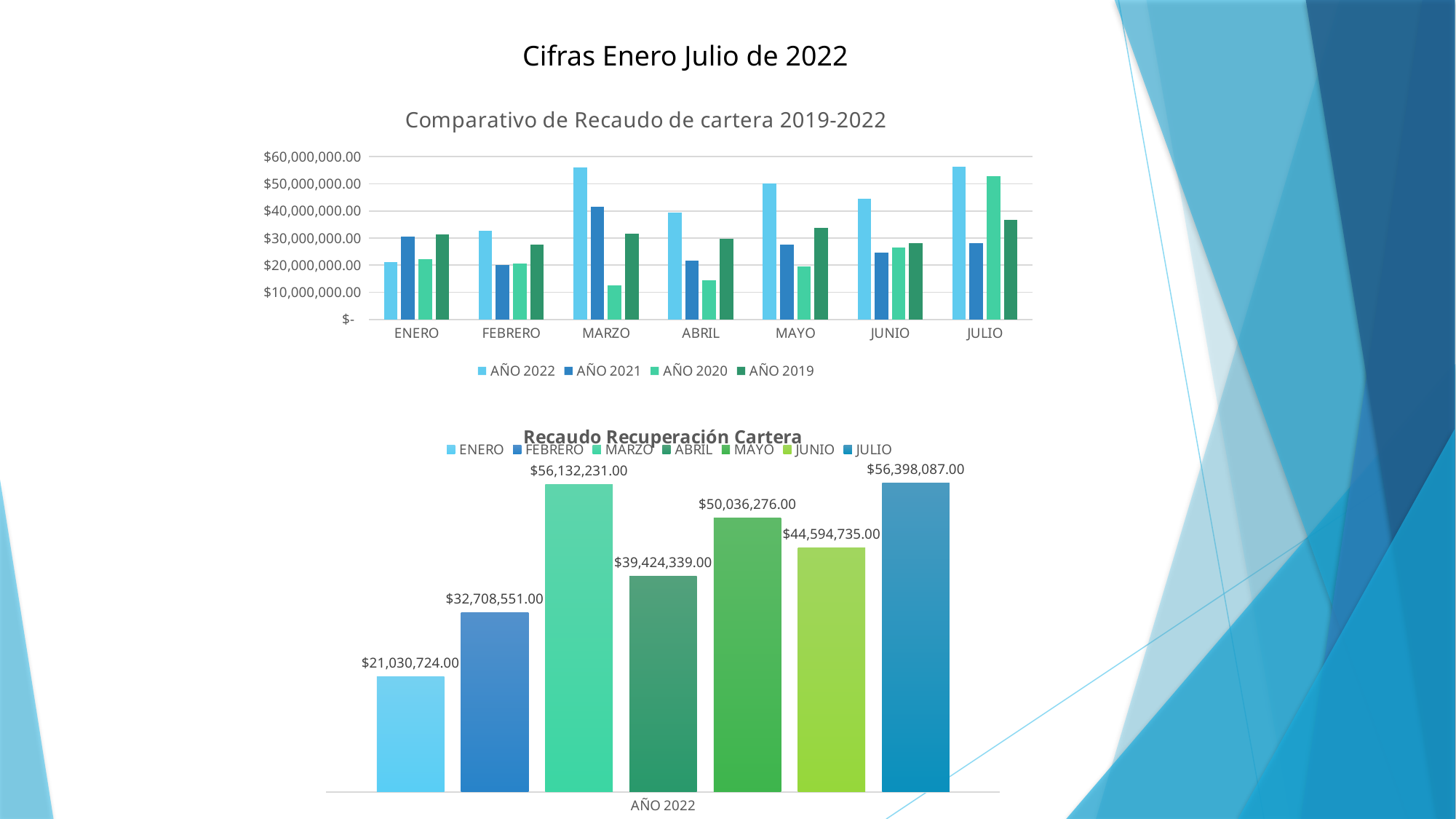
What kind of chart is the top chart 'Comparativo de Recaudo de cartera 2019-2022'? bar chart In the bottom chart 'Recaudo Recuperación Cartera', what is the difference between the values for MAYO and ABRIL? $10,611,937.00 In the top chart 'Comparativo de Recaudo de cartera 2019-2022', how many series does the legend list? 4 In the bottom chart 'Recaudo Recuperación Cartera', which is larger, the value for JUNIO or the value for FEBRERO? JUNIO In the top chart 'Comparativo de Recaudo de cartera 2019-2022', is the value for AÑO 2020 in MARZO greater or less than $20,000,000.00? less In the bottom chart 'Recaudo Recuperación Cartera', which month has the lowest value? ENERO In the bottom chart 'Recaudo Recuperación Cartera', what is the value for ENERO? $21,030,724.00 In the top chart 'Comparativo de Recaudo de cartera 2019-2022', how many months are shown on the x axis? 7 In the bottom chart 'Recaudo Recuperación Cartera', which month has the highest value? JULIO In the top chart 'Comparativo de Recaudo de cartera 2019-2022', which month has the highest value for AÑO 2020? JULIO In the bottom chart 'Recaudo Recuperación Cartera', what is the value for MARZO? $56,132,231.00 In the top chart 'Comparativo de Recaudo de cartera 2019-2022', is the value for AÑO 2022 in MARZO greater or less than $50,000,000.00? greater